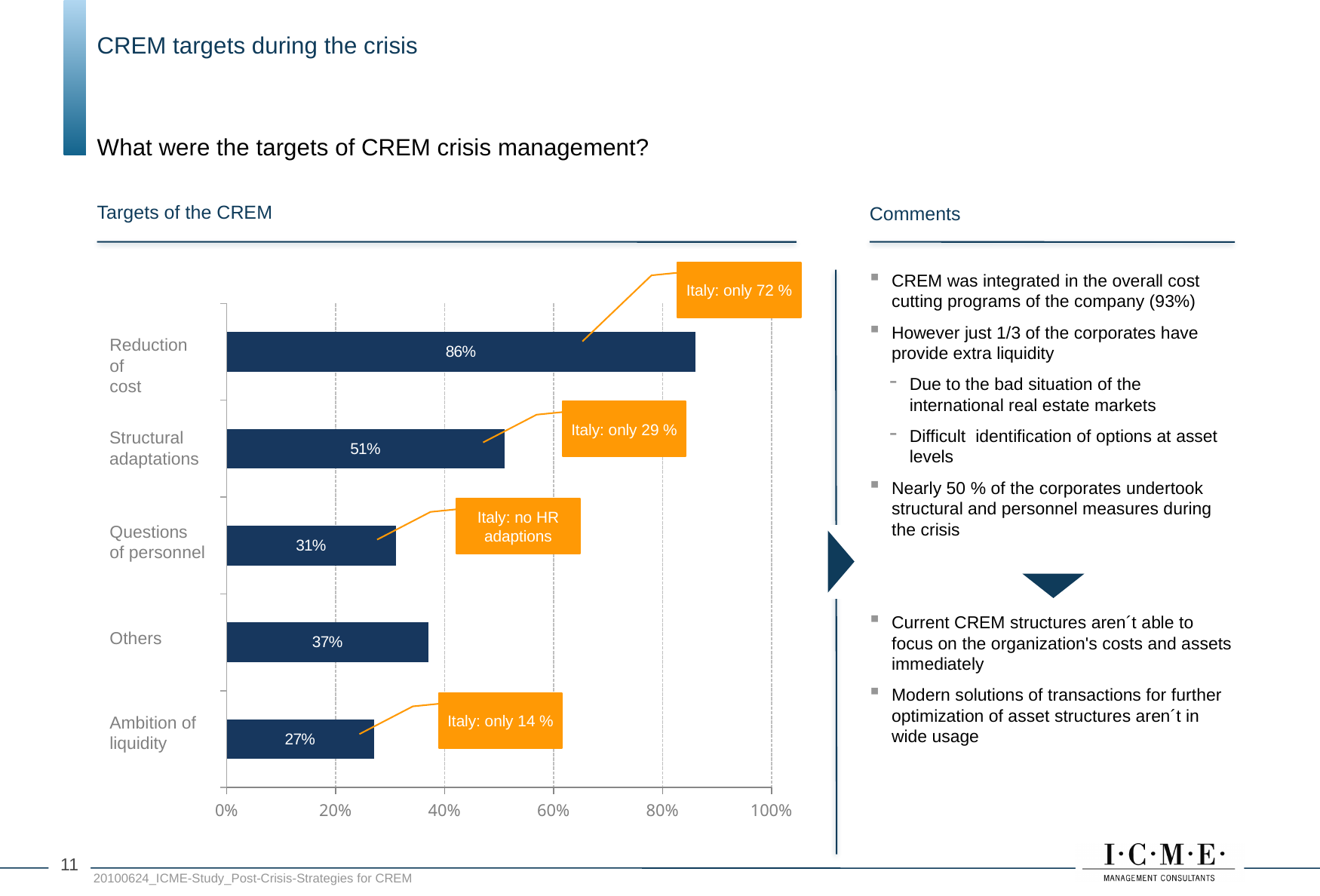
Is the value for Structural adaptations greater or less than 40%? greater What is the title of the chart? Targets of the CREM What is the value for Reduction of cost? 86% What kind of chart is shown on the slide? bar chart What is the value for Ambition of liquidity? 27% What is the value for Structural adaptations? 51% What is the difference between Reduction of cost and Structural adaptations? 35% What does the orange callout attached to the Reduction of cost bar say? Italy: only 72 % How many categories are shown in the chart? 5 Which category has the lowest value? Ambition of liquidity Which is larger, Others or Questions of personnel? Others Which category has the highest value? Reduction of cost